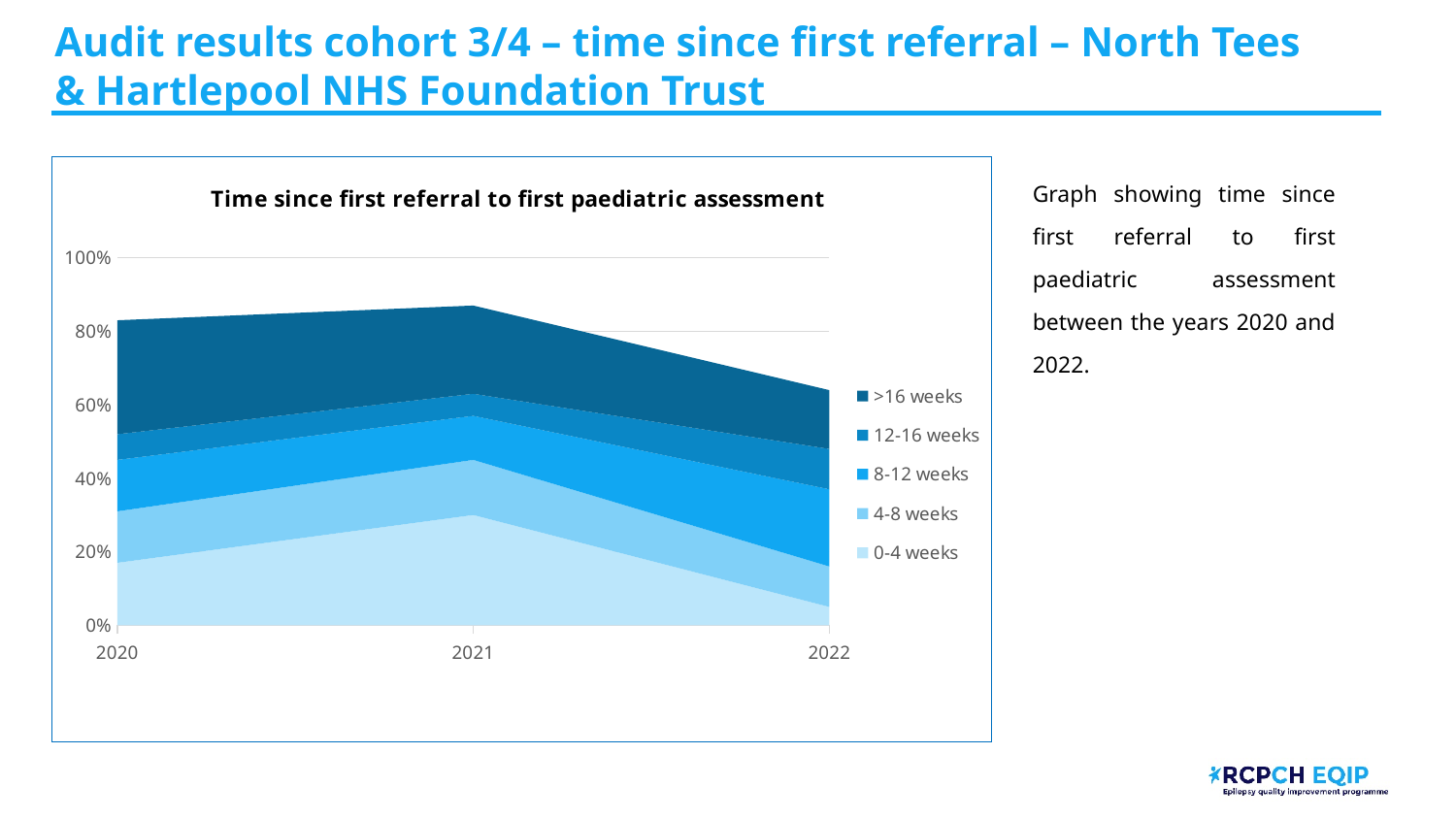
What kind of chart is shown on the slide? Stacked area chart In which year is the 0-4 weeks band at its highest? 2021 Is the top of the whole stacked area in 2022 greater or less than 80%? less What is the title of the chart? Time since first referral to first paediatric assessment Does the top of the stacked area rise or fall from 2021 to 2022? fall Is the top of the whole stacked area in 2021 greater or less than 80%? greater Is the top of the 0-4 weeks band in 2021 greater or less than 20%? greater Does the 0-4 weeks band rise or fall from 2020 to 2021? rise How many series does the chart's legend list? 5 Which legend entry represents the longest waiting time band? >16 weeks How many years are plotted along the x axis of the chart? 3